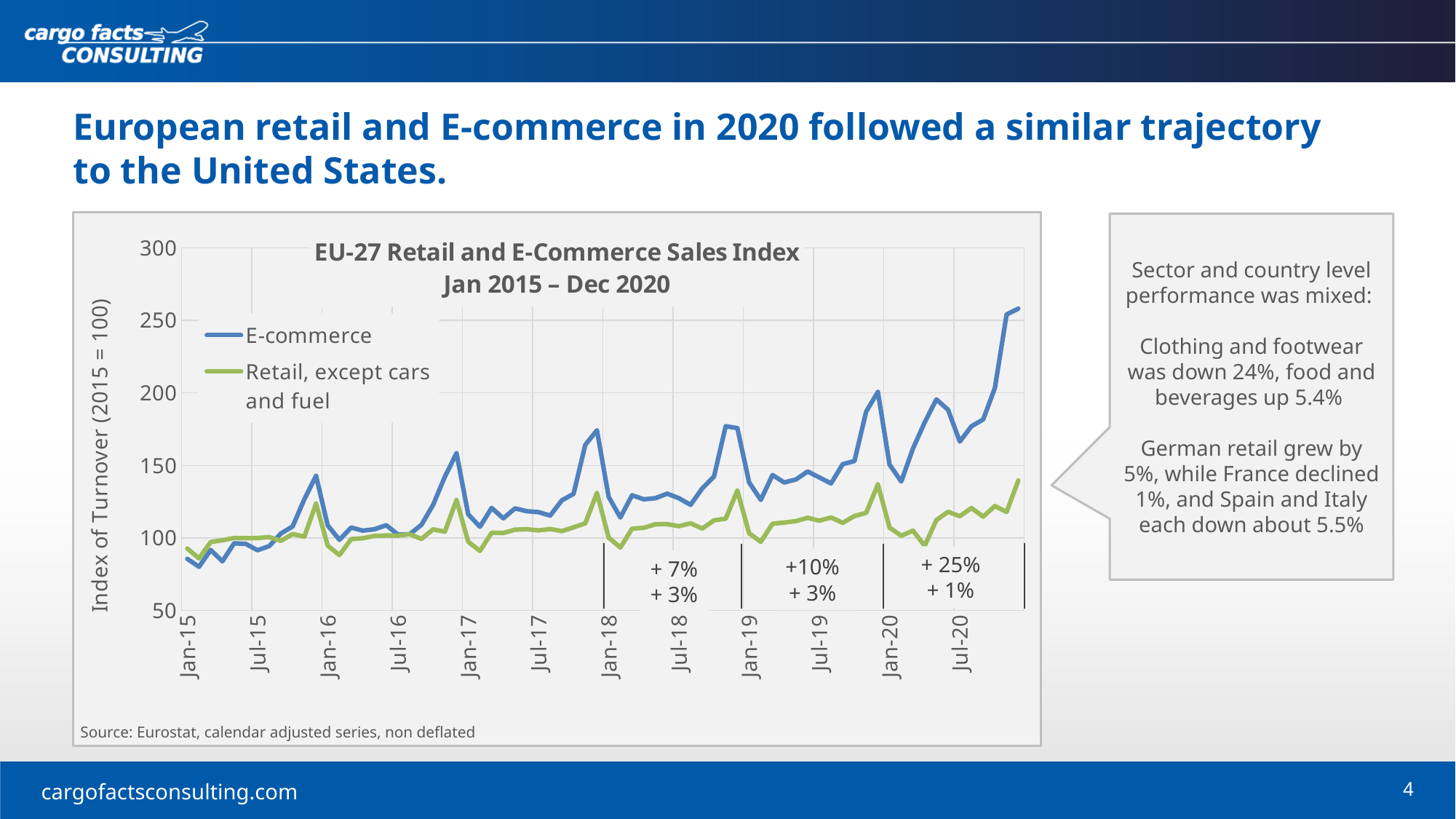
At the end of 2020, which series is higher: E-commerce or Retail, except cars and fuel? E-commerce Does the E-commerce series generally rise or fall from Jan-15 to the end of 2020? rise Is the E-commerce value in Jan-19 greater or less than 150? less Is the value for Retail, except cars and fuel at the end of 2020 greater or less than 150? less What is the label of the vertical axis? Index of Turnover (2015 = 100) What annotated growth rate is shown for E-commerce in the 2020 segment of the chart? + 25% What kind of chart is shown on the slide? line chart Which series reaches the highest value on the chart? E-commerce What is the title of the chart? EU-27 Retail and E-Commerce Sales Index Jan 2015 – Dec 2020 How many series does the legend list? 2 Is the E-commerce value in Jan-15 greater or less than 100? less